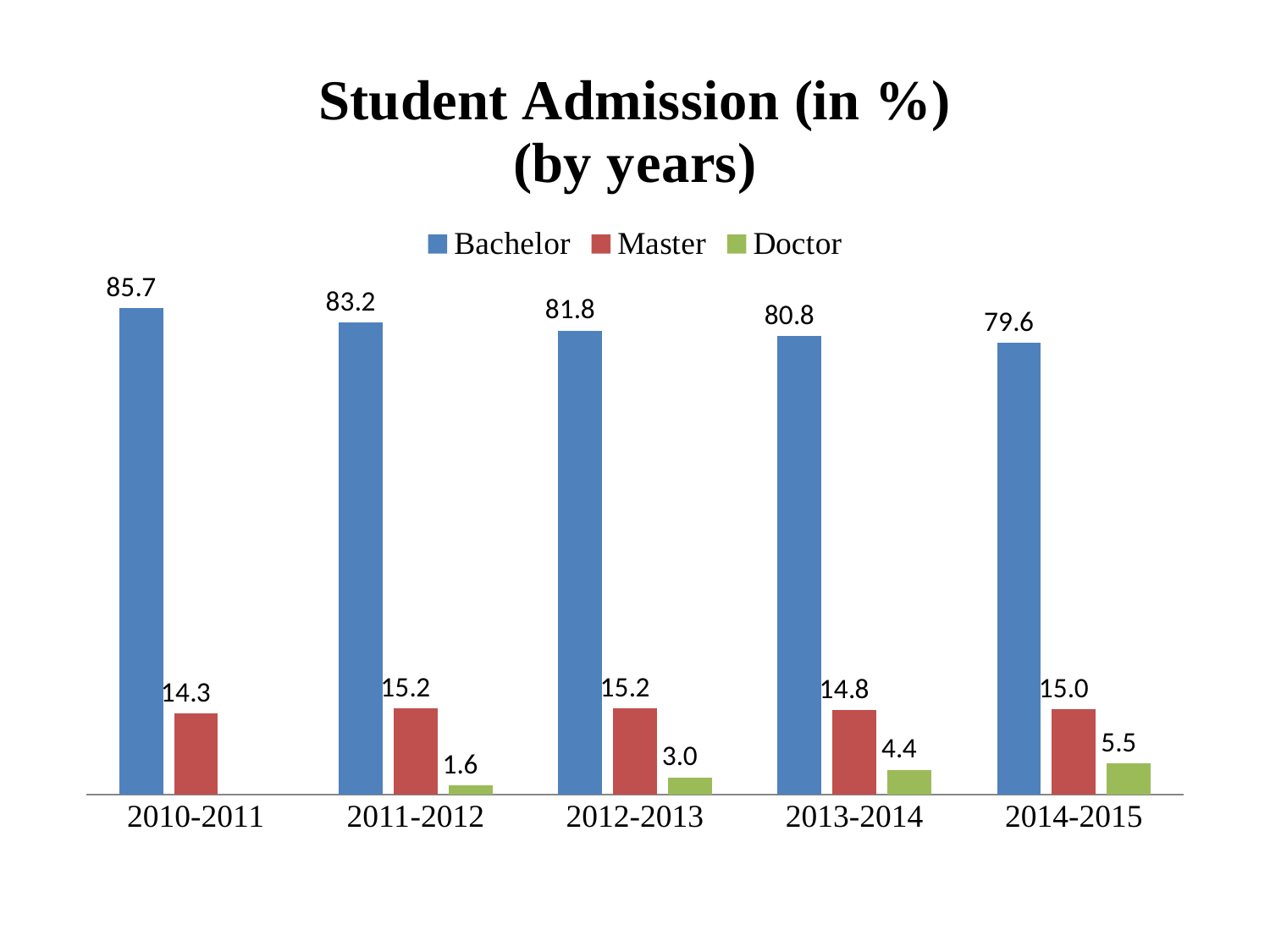
How many year categories are shown on the x axis? 5 What is the title of the chart? Student Admission (in %) (by years) What is the Bachelor value for 2010-2011? 85.7 Do the Bachelor values rise or fall from 2010-2011 to 2014-2015? Fall What is the Master value for 2013-2014? 14.8 How many series does the legend list? 3 Which is larger, the Master value for 2011-2012 or the Master value for 2010-2011? 2011-2012 What is the Doctor value for 2012-2013? 3.0 What is the difference between the Bachelor values for 2010-2011 and 2014-2015? 6.1 Which year has the highest Bachelor value? 2010-2011 What kind of chart is shown on the slide? Bar chart Which year has the lowest Doctor value among those with a Doctor bar? 2011-2012